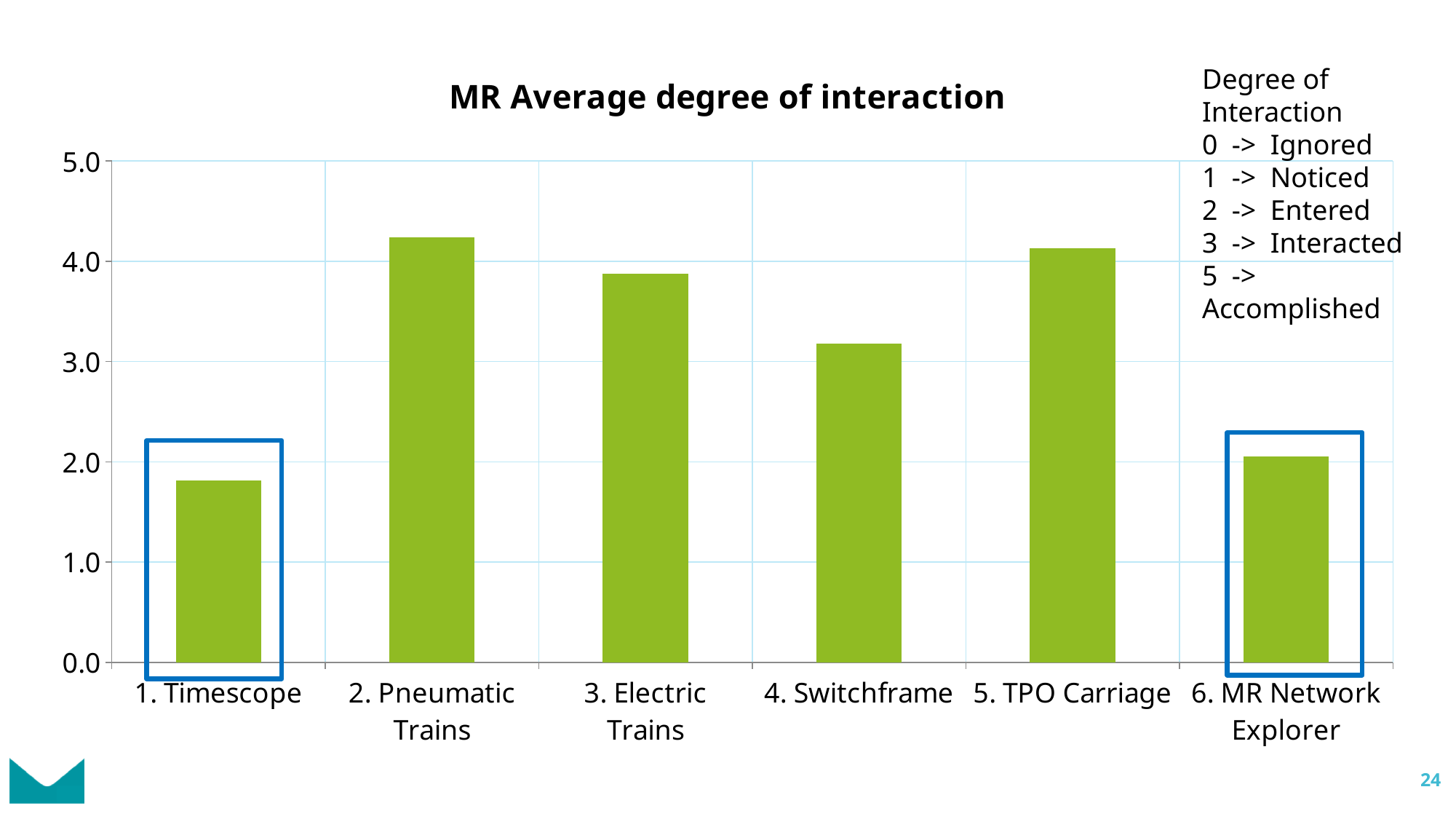
What type of chart is shown on the slide? Bar chart Is the value for 2. Pneumatic Trains greater or less than 4.0? greater Which has a higher value, 3. Electric Trains or 6. MR Network Explorer? 3. Electric Trains Which two bars are outlined with blue boxes on the chart? 1. Timescope and 6. MR Network Explorer Which category has the lowest average degree of interaction? 1. Timescope Is the value for 1. Timescope greater or less than 2.0? less Is the value for 3. Electric Trains greater or less than 4.0? less What is the title of the chart? MR Average degree of interaction How many categories are plotted on the x axis? 6 Which has a higher value, 2. Pneumatic Trains or 4. Switchframe? 2. Pneumatic Trains